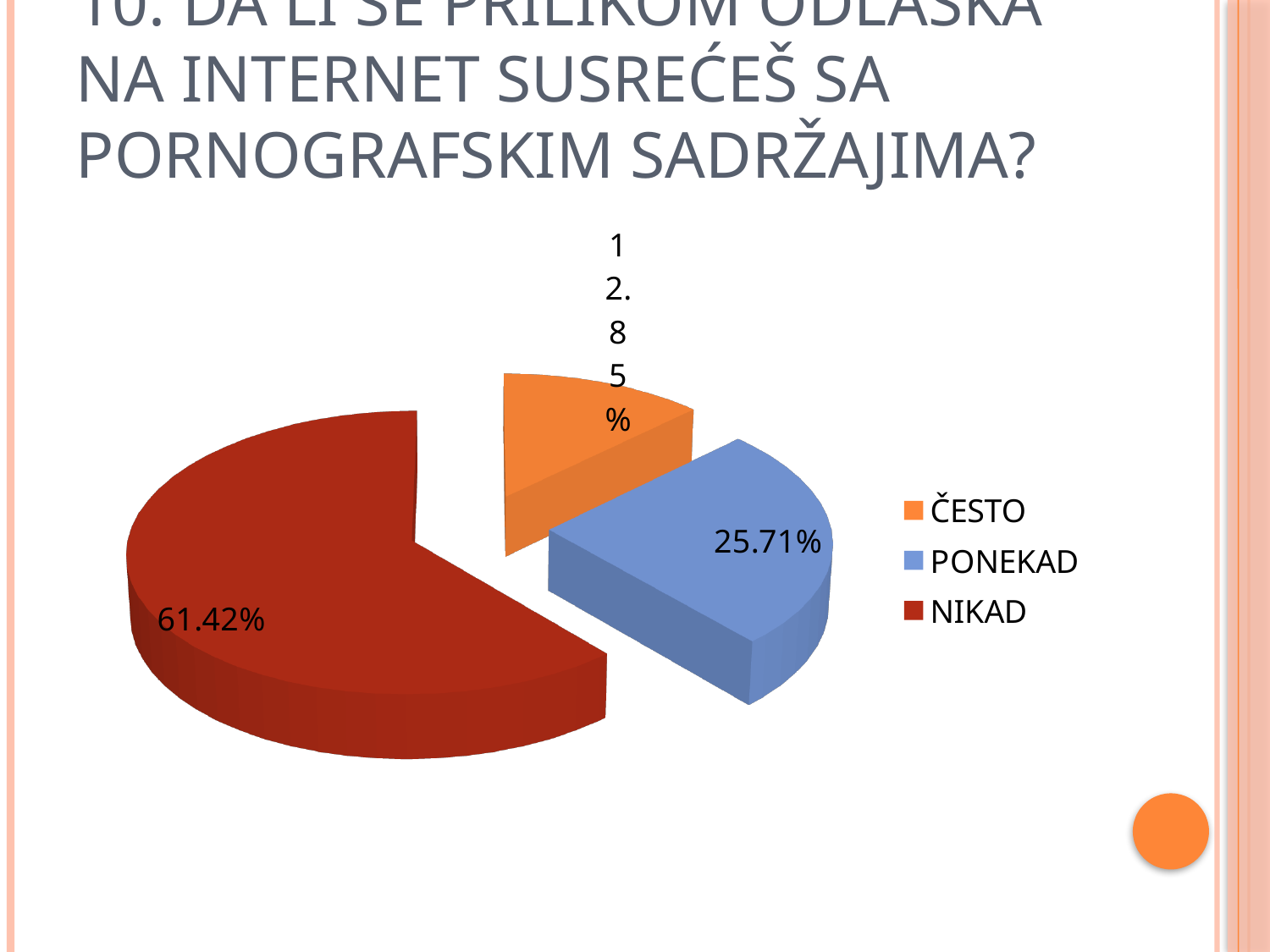
What percentage is shown for NIKAD? 61.42% What is the difference between the NIKAD share and the PONEKAD share? 35.71% What kind of chart is shown on the slide? pie chart Which is larger, the share for PONEKAD or the share for ČESTO? PONEKAD What colour is the slice for PONEKAD? blue What is the difference between the PONEKAD share and the ČESTO share? 12.86% What percentage is shown for PONEKAD? 25.71% How many slices does the pie chart have? 3 What percentage is shown for ČESTO? 12.85% Which category has the smallest share of the pie? ČESTO Which category has the largest share of the pie? NIKAD How many entries does the legend list? 3